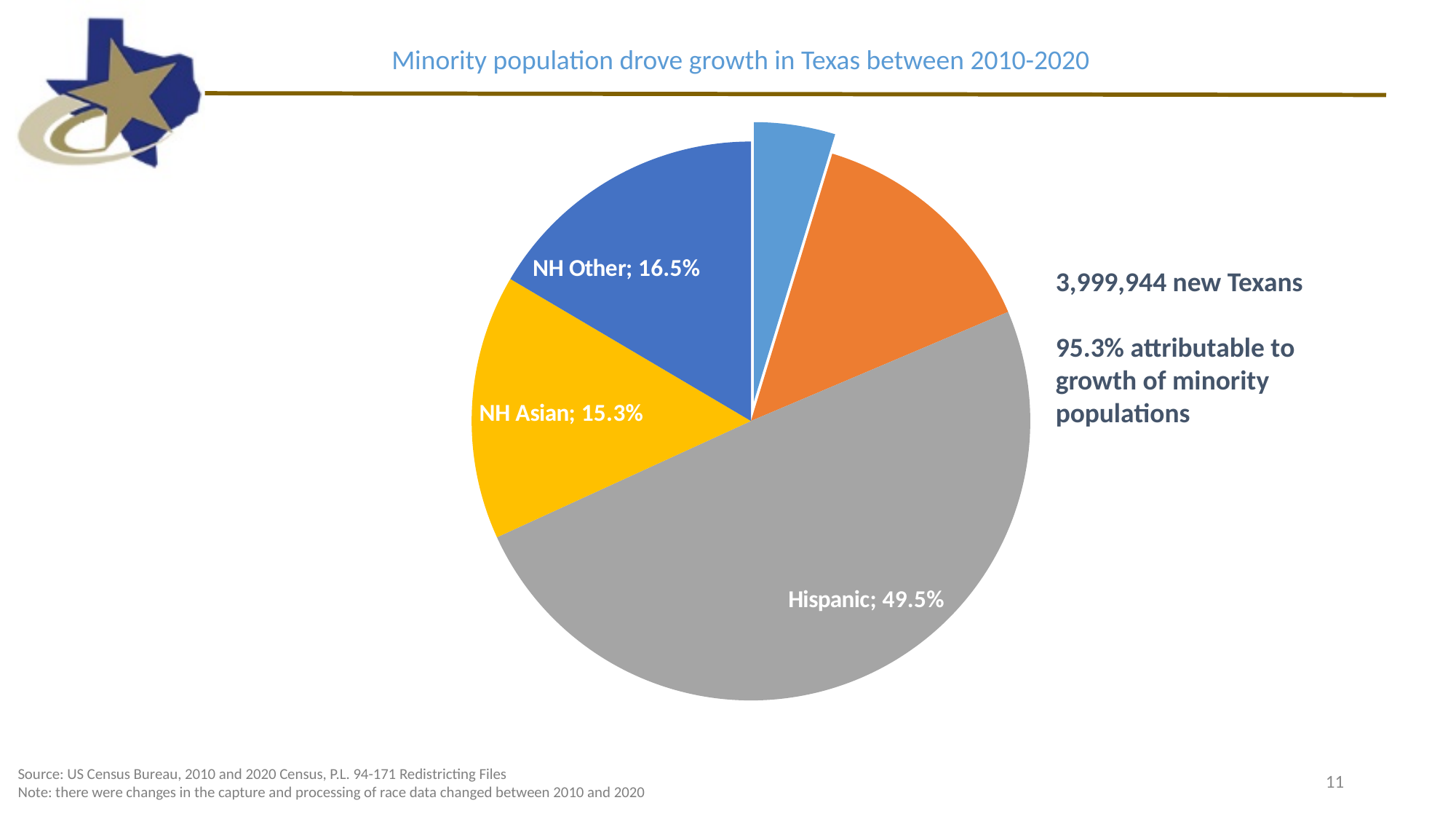
What is the value shown for the NH Asian slice? 15.3% What is the combined share of the NH Asian and NH Other slices? 31.8% Which labeled slice of the pie is the largest? Hispanic What is the title of the slide containing the chart? Minority population drove growth in Texas between 2010-2020 What is the difference in percentage points between the NH Other slice and the NH Asian slice? 1.2 How many slices does the pie chart have? 5 What is the difference in percentage points between the Hispanic slice and the NH Asian slice? 34.2 What percentage of the pie does the Hispanic slice represent? 49.5% Which labeled slice of the pie is the smallest? NH Asian What kind of chart is shown on the slide? Pie chart What is the value shown for the NH Other slice? 16.5% Which is larger, the NH Other slice or the NH Asian slice? NH Other